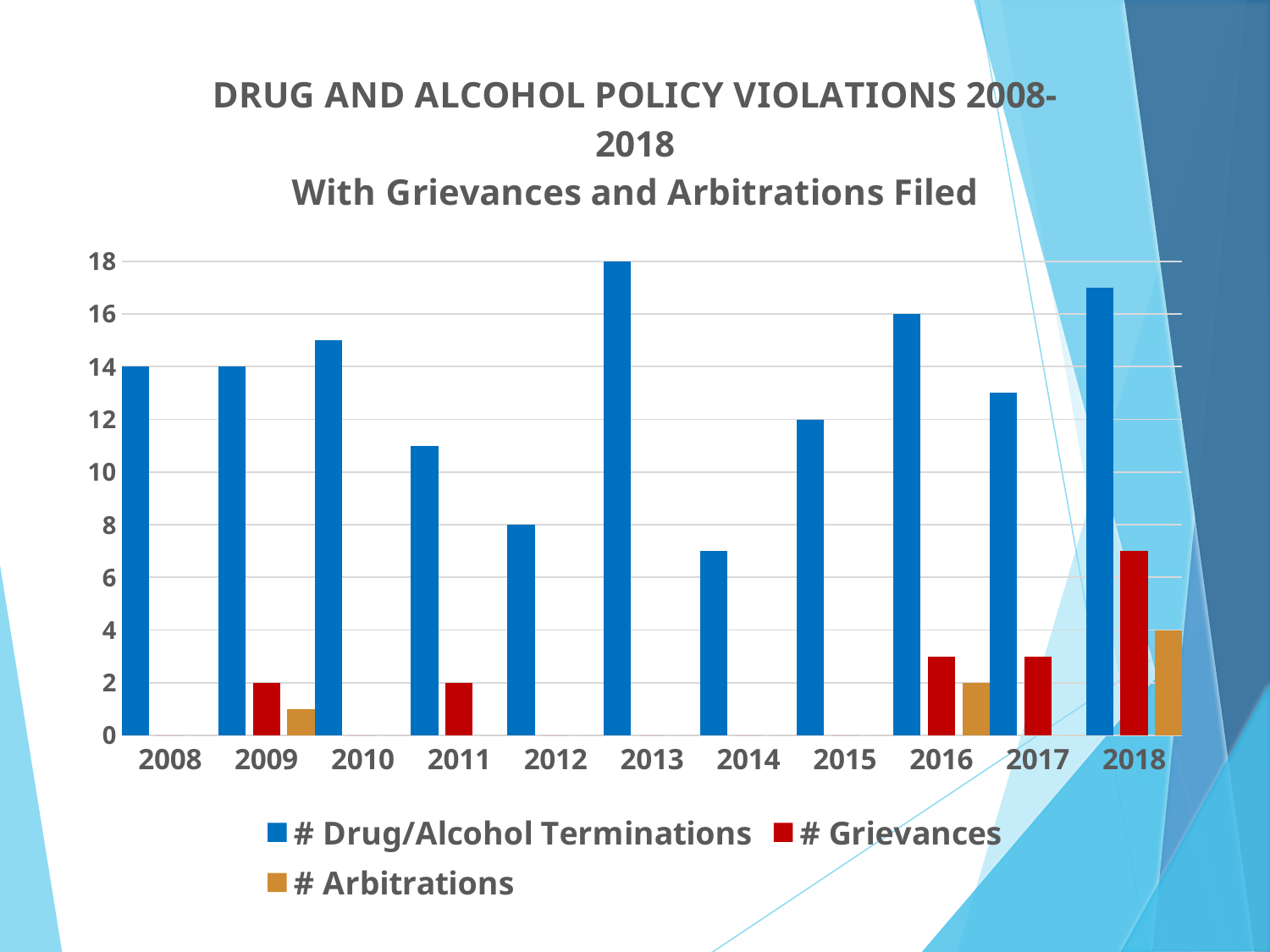
How many series does the legend list? 3 What is the number of Arbitrations in 2018? 4 What is the number of Drug/Alcohol Terminations in 2012? 8 Which is larger, the number of Drug/Alcohol Terminations in 2015 or in 2017? 2017 Which year has the highest number of Drug/Alcohol Terminations? 2013 How many years are shown on the x axis? 11 What is the difference between the number of Drug/Alcohol Terminations in 2013 and in 2012? 10 What is the number of Drug/Alcohol Terminations in 2016? 16 What kind of chart is shown on the slide? bar chart What is the number of Drug/Alcohol Terminations in 2013? 18 Is the number of Drug/Alcohol Terminations in 2010 greater or less than 14? greater Which year has the lowest number of Drug/Alcohol Terminations? 2014